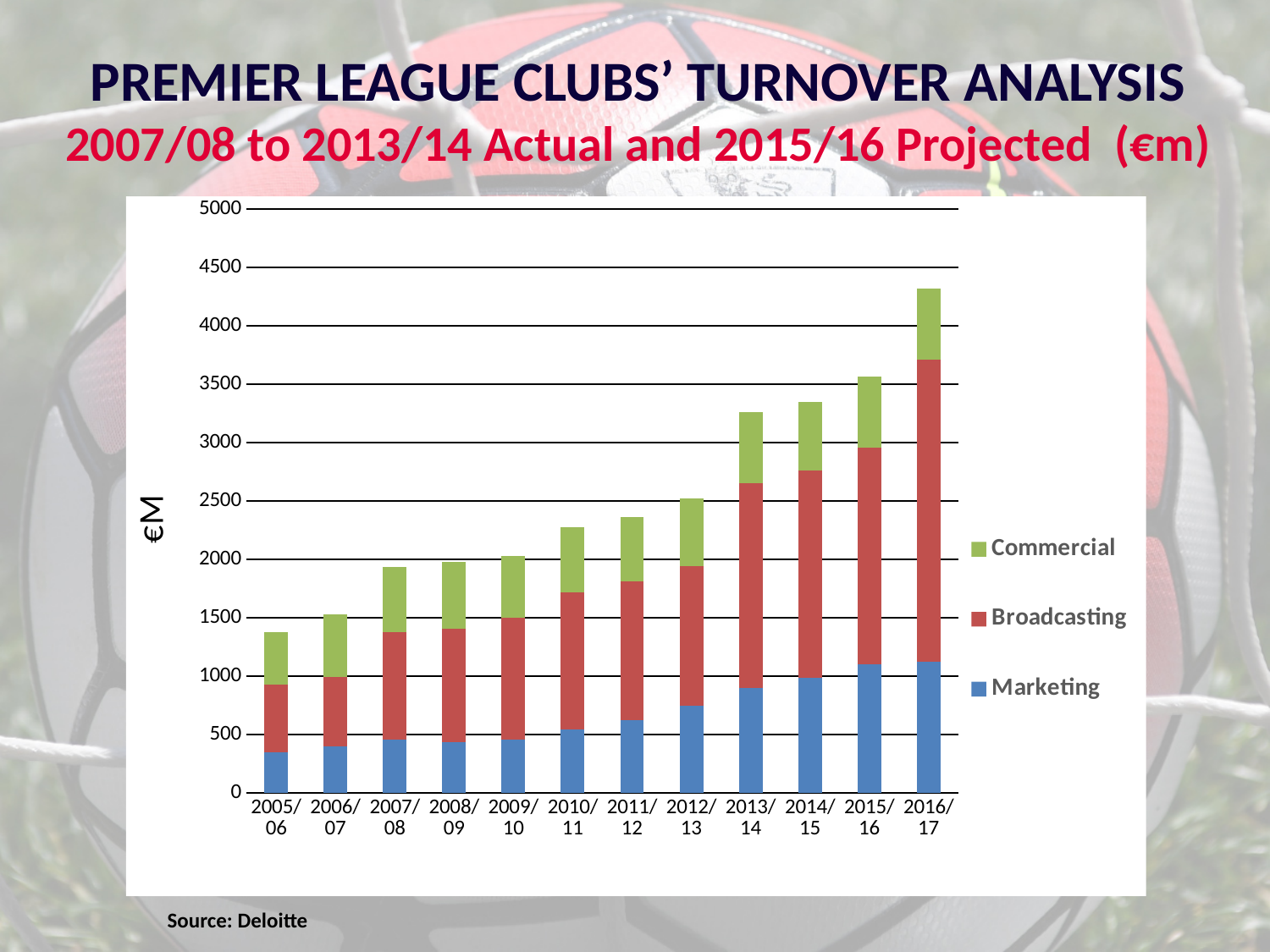
Is the Marketing value for 2005/06 greater or less than 500? less Do the total turnover bars generally rise or fall from 2005/06 to 2016/17? Rise Which season has the larger Marketing segment, 2013/14 or 2005/06? 2013/14 Is the total turnover bar for 2005/06 greater or less than 1500? less How many series does the chart's legend list? 3 Which colour represents the Broadcasting series in the chart? Red Is the total turnover bar for 2013/14 greater or less than 3000? greater What kind of chart is shown on the slide? Stacked bar chart How many seasons (categories) are shown on the x axis of the chart? 12 Which season has the lowest total turnover bar? 2005/06 Which season has the highest total turnover bar? 2016/17